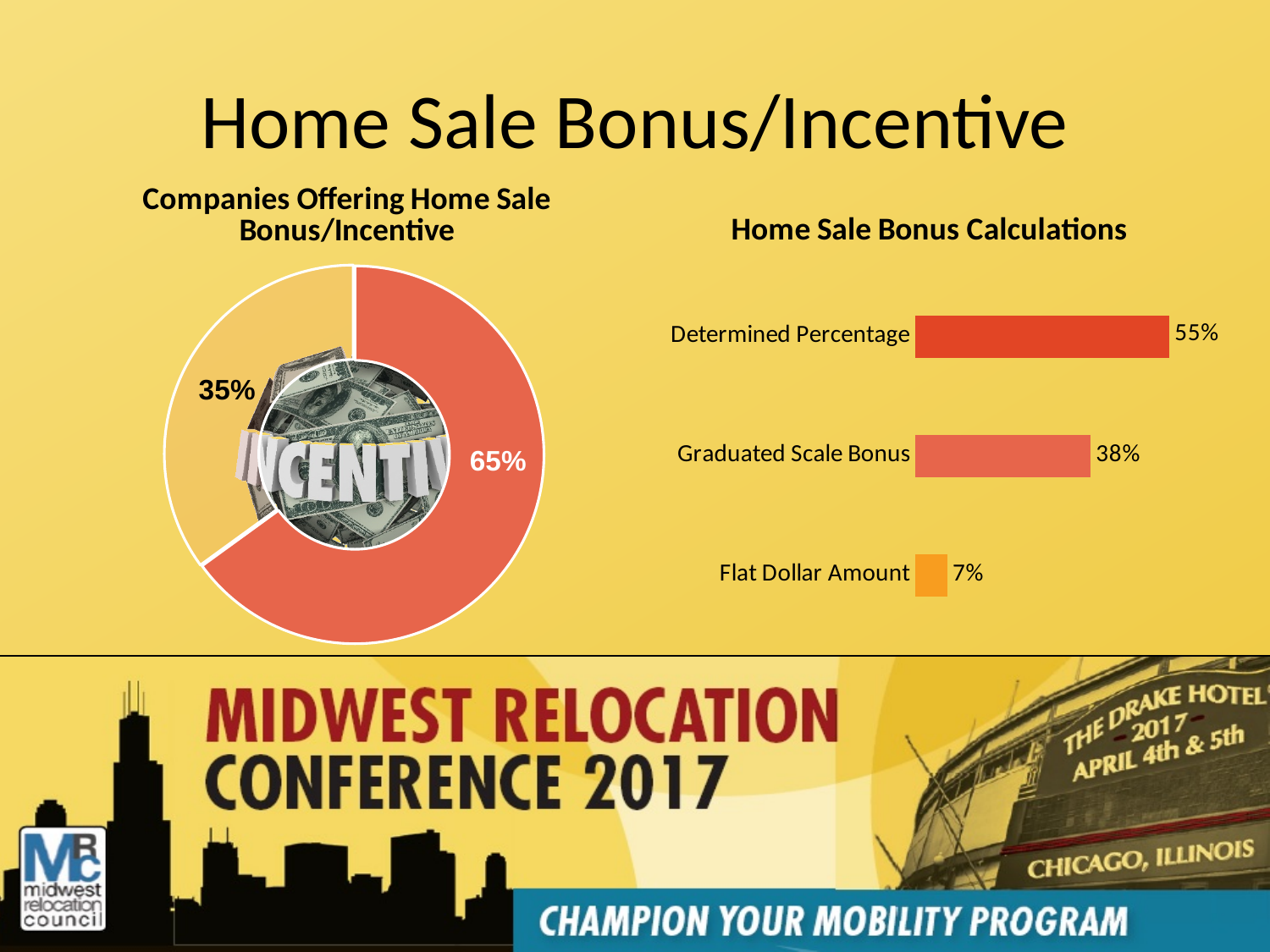
In the 'Companies Offering Home Sale Bonus/Incentive' chart, what is the difference between the two slices? 30% In the 'Home Sale Bonus Calculations' chart, what is the value for Graduated Scale Bonus? 38% In the 'Companies Offering Home Sale Bonus/Incentive' chart, what share does the larger slice represent? 65% What kind of chart is the 'Companies Offering Home Sale Bonus/Incentive' chart? Doughnut chart What kind of chart is the 'Home Sale Bonus Calculations' chart? Bar chart In the 'Home Sale Bonus Calculations' chart, what is the difference between Determined Percentage and Graduated Scale Bonus? 17% In the 'Home Sale Bonus Calculations' chart, which category has the lowest value? Flat Dollar Amount In the 'Home Sale Bonus Calculations' chart, which is larger: Graduated Scale Bonus or Flat Dollar Amount? Graduated Scale Bonus In the 'Home Sale Bonus Calculations' chart, what is the value for Determined Percentage? 55% In the 'Home Sale Bonus Calculations' chart, what is the value for Flat Dollar Amount? 7% In the 'Home Sale Bonus Calculations' chart, which category has the highest value? Determined Percentage How many categories are shown in the 'Home Sale Bonus Calculations' chart? 3